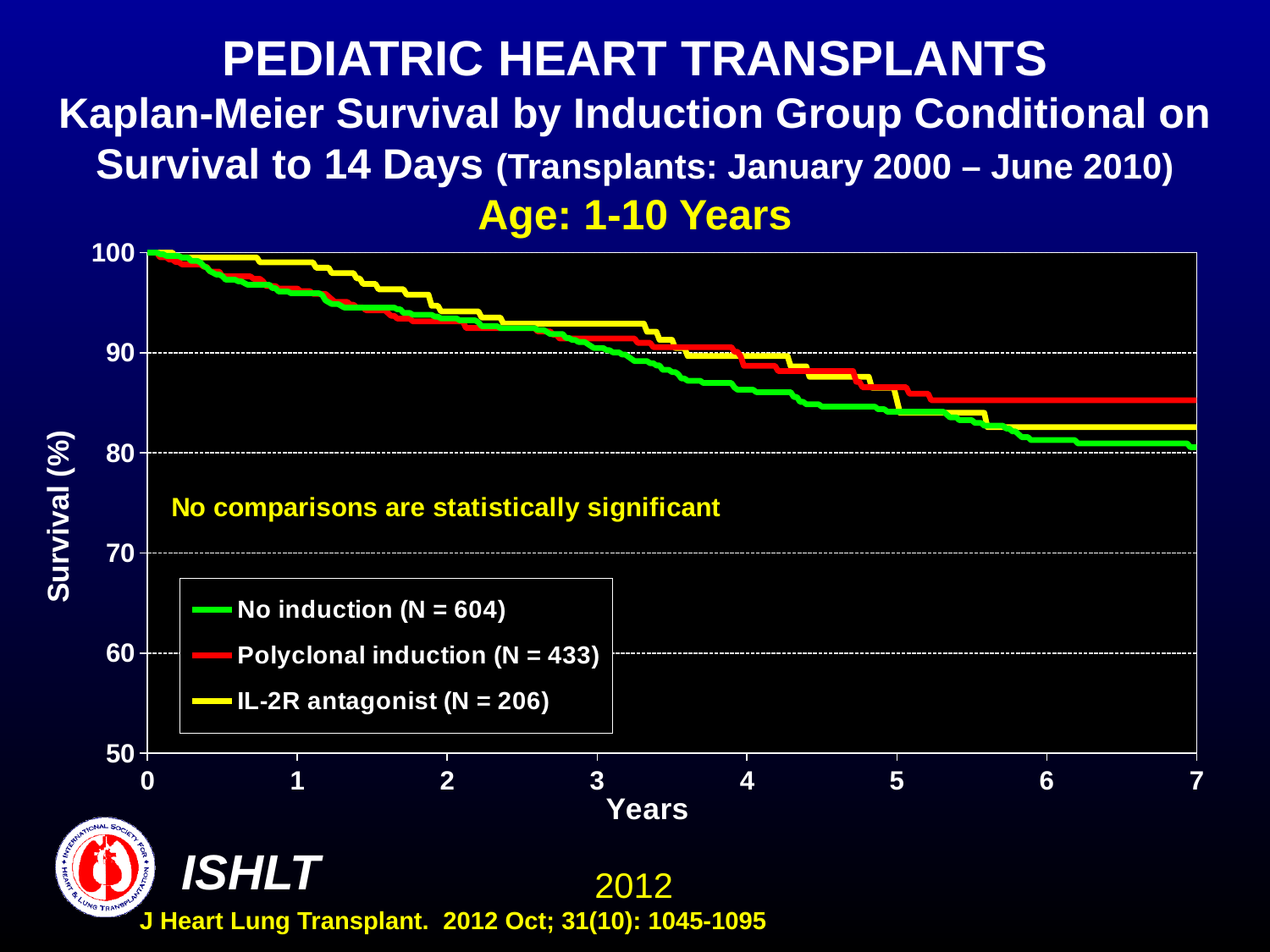
Is the survival value for the Polyclonal induction group at 7 years greater or less than 80? greater At 7 years, which is larger: survival for Polyclonal induction or for No induction? Polyclonal induction What kind of chart is shown on the slide? Line chart What is the N for the IL-2R antagonist group shown in the legend? 206 What is the N for the Polyclonal induction group shown in the legend? 433 Is the survival value for the No induction group at 7 years greater or less than 90? less Is the survival value for the IL-2R antagonist group at 1 year greater or less than 90? greater Which induction group has the highest survival at 7 years? Polyclonal induction What note about statistical significance is printed on the chart? No comparisons are statistically significant What is the N for the No induction group shown in the legend? 604 Do the survival curves rise or fall as years increase? Fall How many series does the legend list? 3